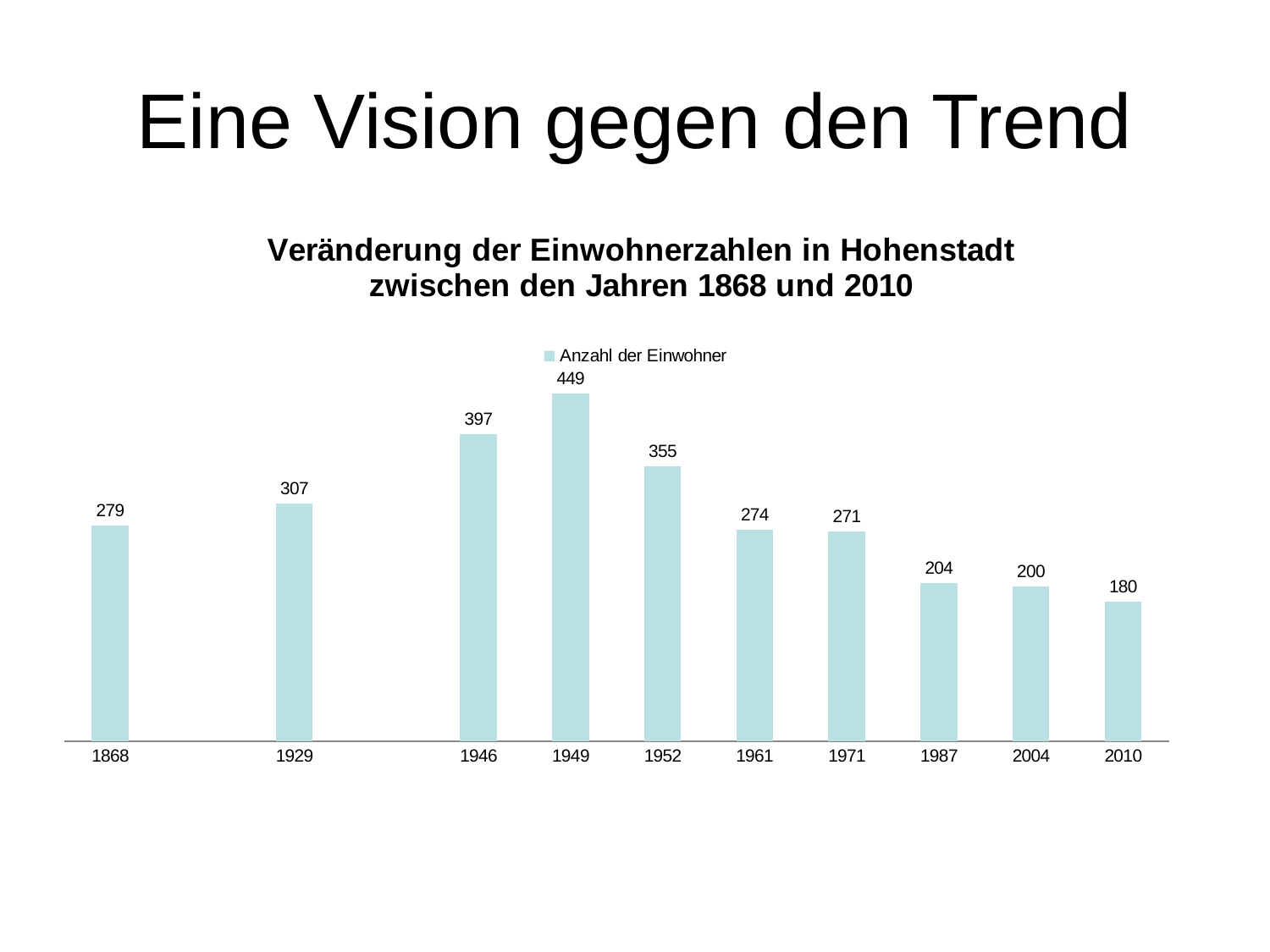
What is the difference between the number of inhabitants in 1949 and in 2010? 269 Which year has more inhabitants, 1929 or 1961? 1929 Which year has the highest number of inhabitants? 1949 What is the legend entry of the chart? Anzahl der Einwohner What is the number of inhabitants shown for 1949? 449 Which year has the lowest number of inhabitants? 2010 What kind of chart is shown on the slide? bar chart What is the difference between the number of inhabitants in 1946 and in 1952? 42 How many years are shown on the x axis of the chart? 10 What is the number of inhabitants shown for 2010? 180 What is the number of inhabitants shown for 1868? 279 How many series does the legend list? 1